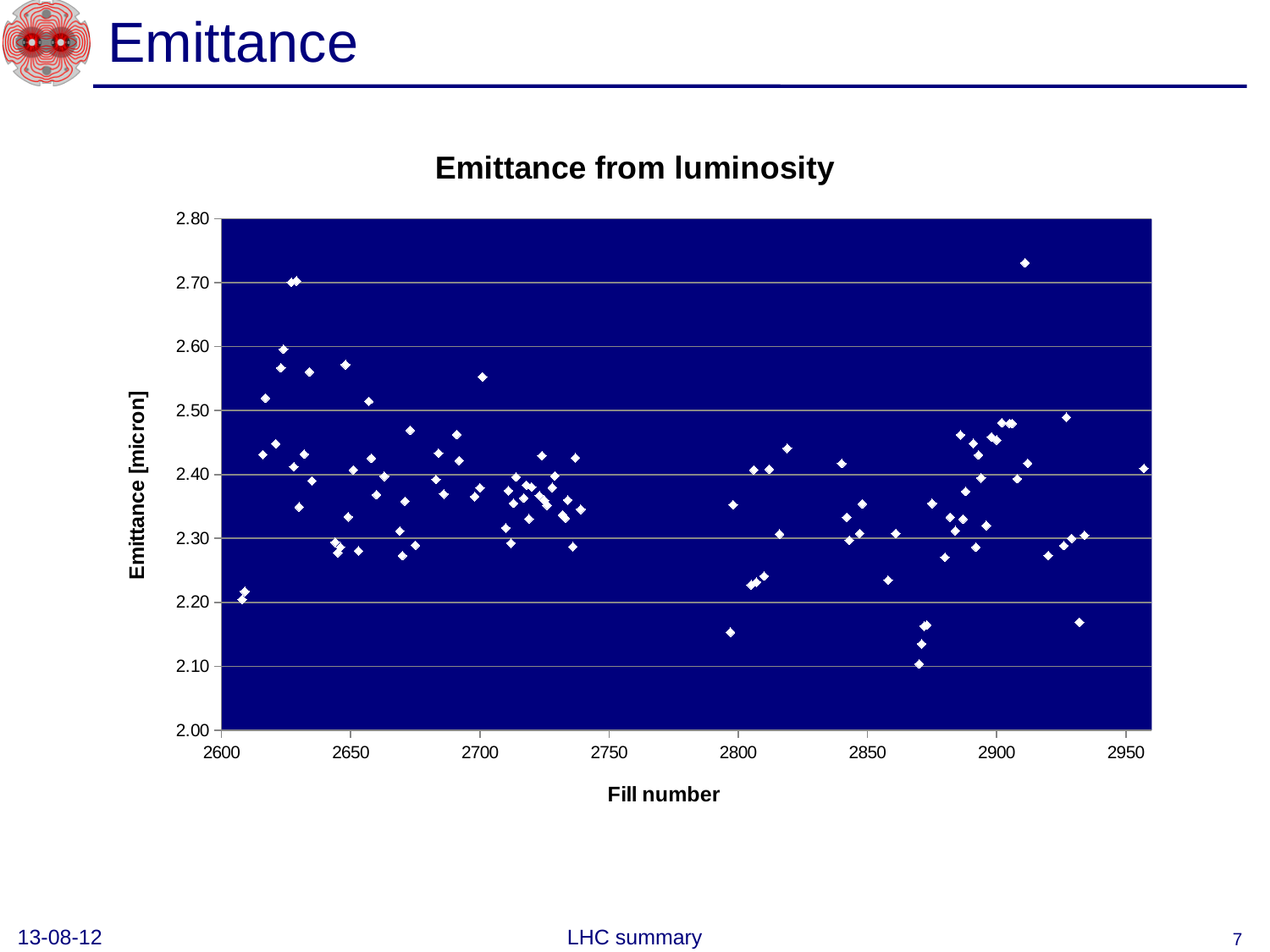
What kind of chart is shown on the slide? Scatter chart Is the lowest plotted point greater or less than 2.00? greater Is the lowest plotted point greater or less than 2.20? less What is the label of the y axis? Emittance [micron] Is the highest point near fill number 2910 greater or less than 2.60? greater What is the title of the chart? Emittance from luminosity